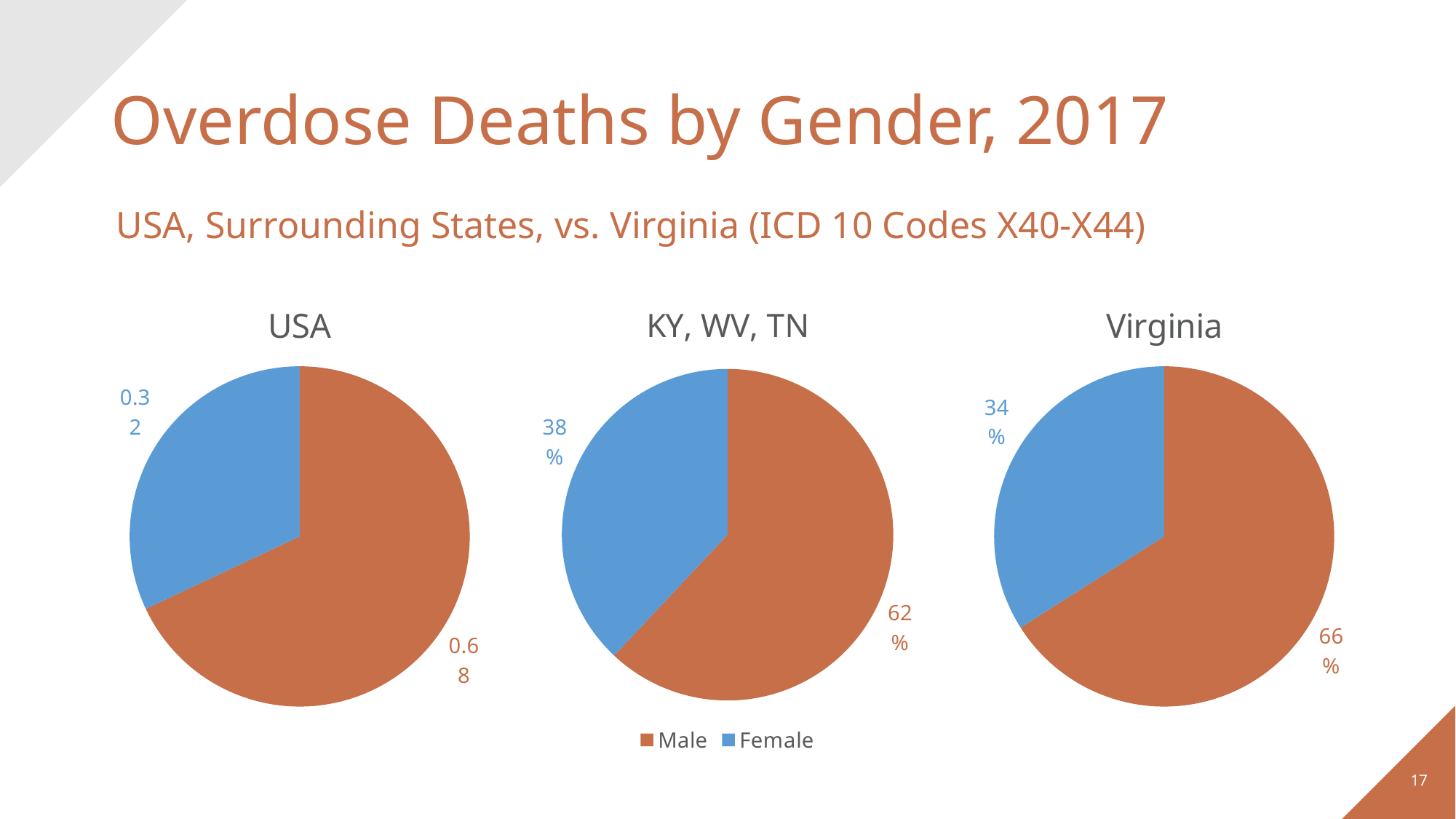
In the KY, WV, TN pie chart, what share is Male? 62% In the KY, WV, TN pie chart, what share is Female? 38% In the USA pie chart, what is the value for Male? 0.68 In the Virginia pie chart, which slice is larger, Male or Female? Male In the Virginia pie chart, what share is Male? 66% In the Virginia pie chart, what is the difference between the Male and Female shares? 32% In the Virginia pie chart, what share is Female? 34% How many series does the legend list? 2 In the USA pie chart, what is the value for Female? 0.32 How many pie charts are shown on the slide? 3 What kind of chart is used for the USA, KY, WV, TN and Virginia data? Pie chart In the KY, WV, TN pie chart, what is the difference between the Male and Female shares? 24%